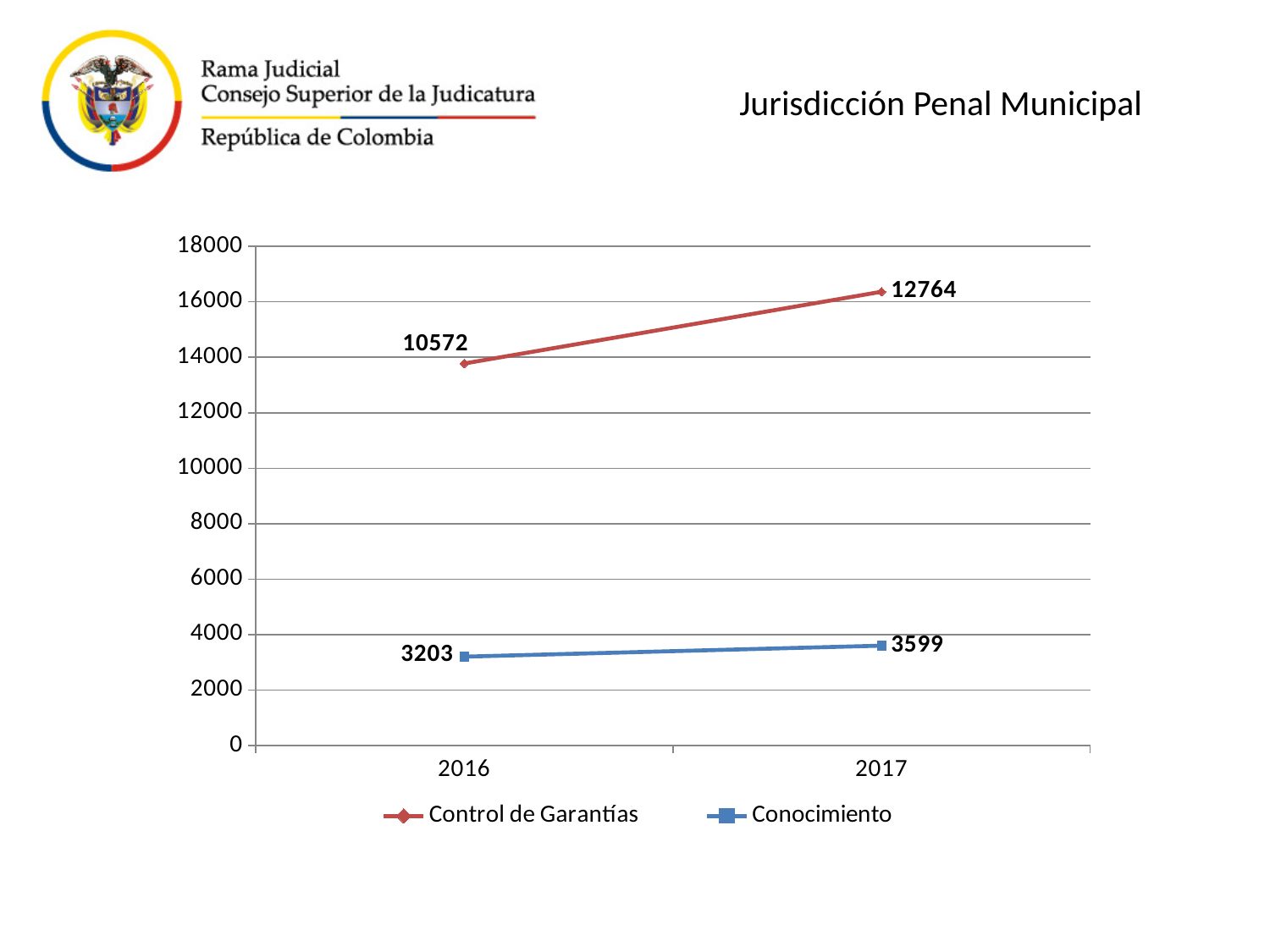
What is the value for Control de Garantías in 2017? 12764 What kind of chart is shown on the slide? line chart By how much did Control de Garantías increase from 2016 to 2017? 2192 Which series has the higher value in 2017, Control de Garantías or Conocimiento? Control de Garantías What is the value for Conocimiento in 2016? 3203 What is the difference between Conocimiento in 2017 and in 2016? 396 Does the Control de Garantías series rise or fall from 2016 to 2017? rise What is the value for Control de Garantías in 2016? 10572 What is the title of the slide containing the chart? Jurisdicción Penal Municipal What is the value for Conocimiento in 2017? 3599 How many series does the legend list? 2 How many years are shown on the x axis? 2